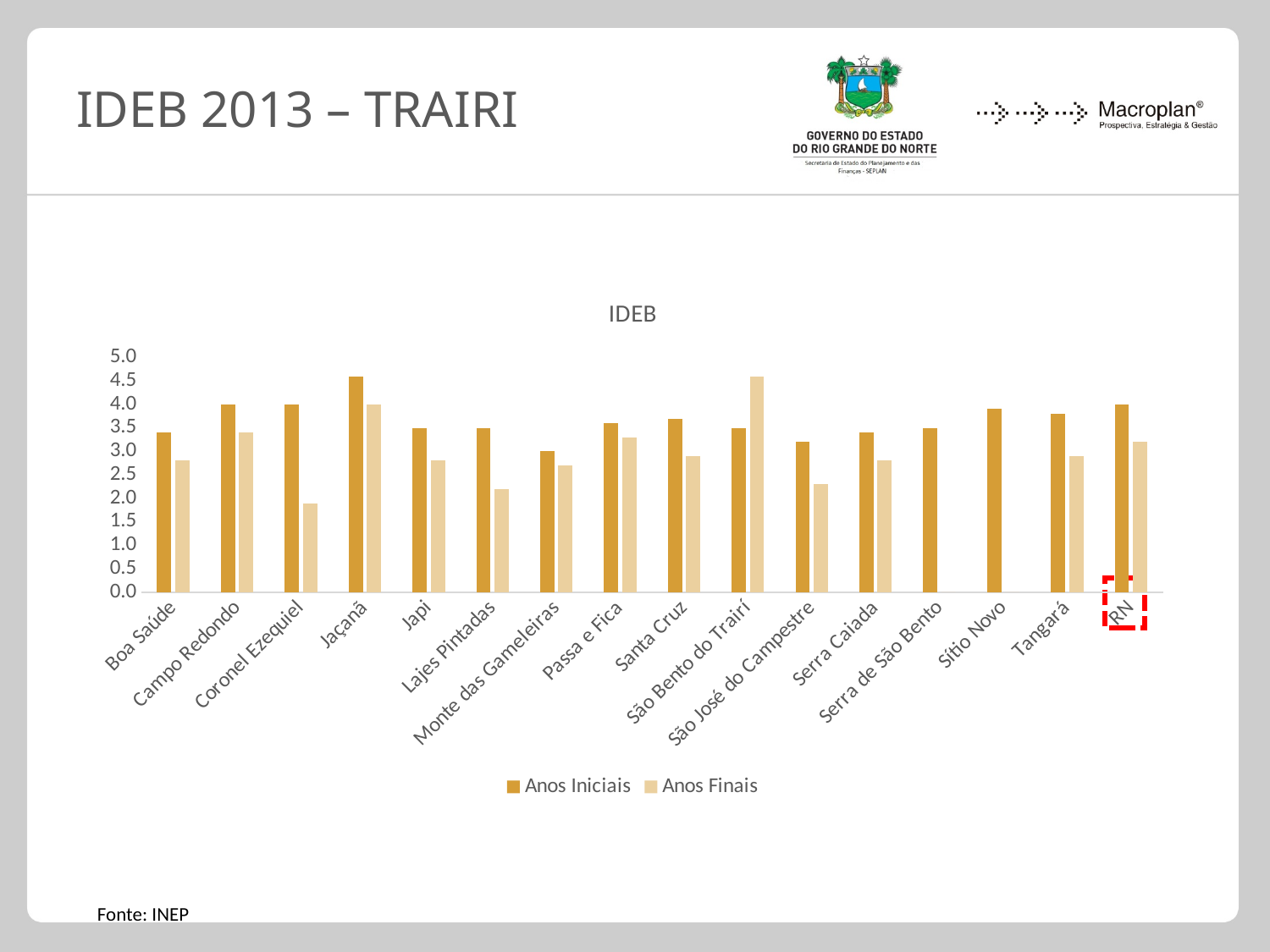
What kind of chart is shown on the slide? bar chart Which category has the highest Anos Iniciais value? Jaçanã Is the Anos Iniciais value for Jaçanã greater or less than 4.0? greater Which category has the highest Anos Finais value? São Bento do Trairí Which category has the lowest Anos Iniciais value? Monte das Gameleiras How many categories are shown along the x axis? 16 For São Bento do Trairí, which is larger: Anos Iniciais or Anos Finais? Anos Finais What is the title of the chart? IDEB How many series does the legend list? 2 What are the two series named in the legend? Anos Iniciais and Anos Finais Is the Anos Finais value for Coronel Ezequiel greater or less than 2.5? less